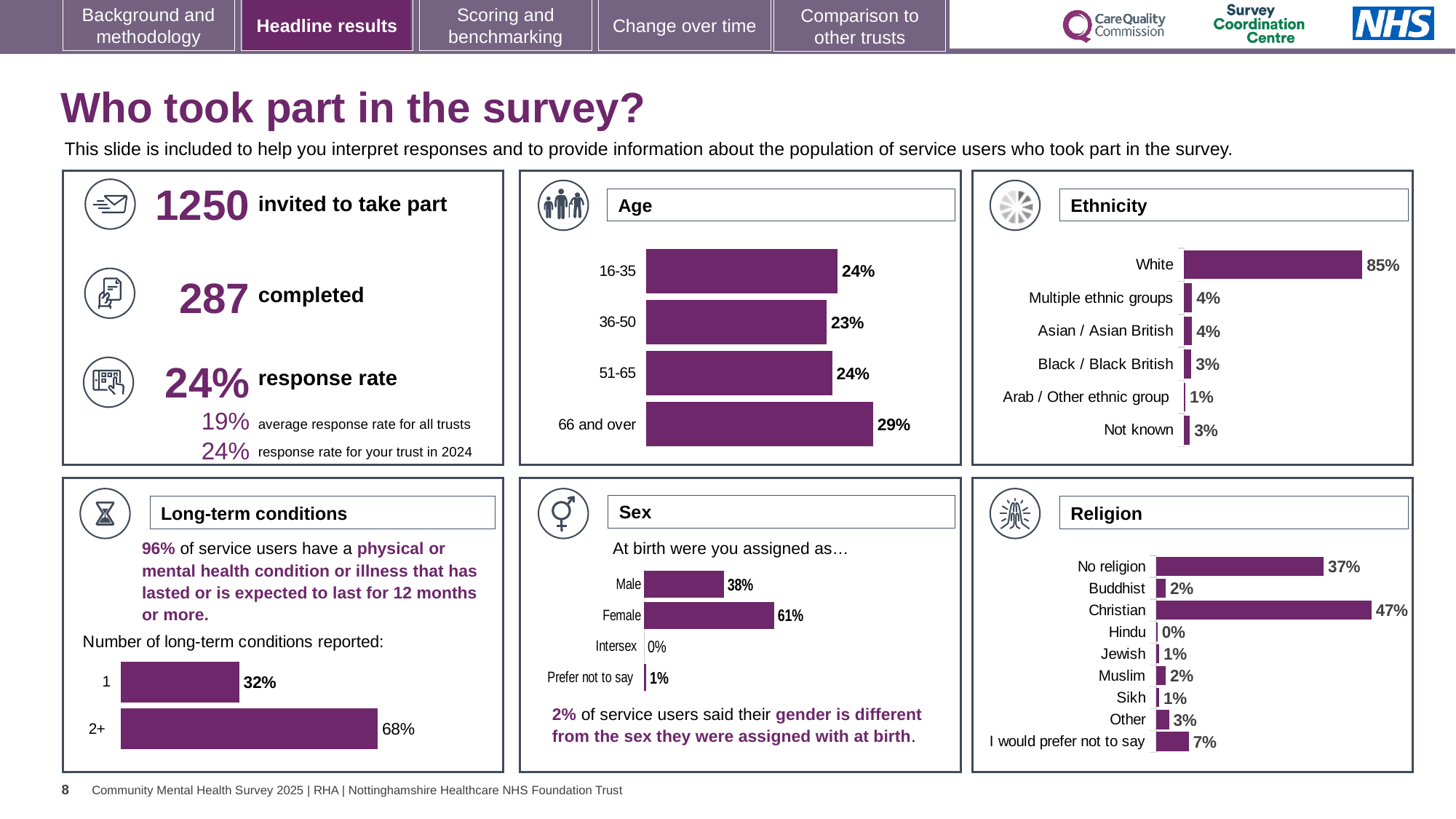
In the Ethnicity chart, what percentage of respondents were White? 85% In the Ethnicity chart, how many categories are shown? 6 In the Sex chart, what is the difference between the Female and Male percentages? 23% What type of chart is used in the Age panel? Bar chart In the Religion chart, which is larger: No religion or Christian? Christian In the Age chart, what percentage of respondents were aged 66 and over? 29% In the Long-term conditions chart, what percentage of respondents reported 2+ conditions? 68% In the Age chart, which age group has the highest percentage? 66 and over In the Religion chart, which category has the highest percentage? Christian In the Religion chart, what percentage of respondents said 'I would prefer not to say'? 7% In the Ethnicity chart, which category has the lowest percentage? Arab / Other ethnic group In the Sex chart, what percentage of respondents answered Intersex? 0%